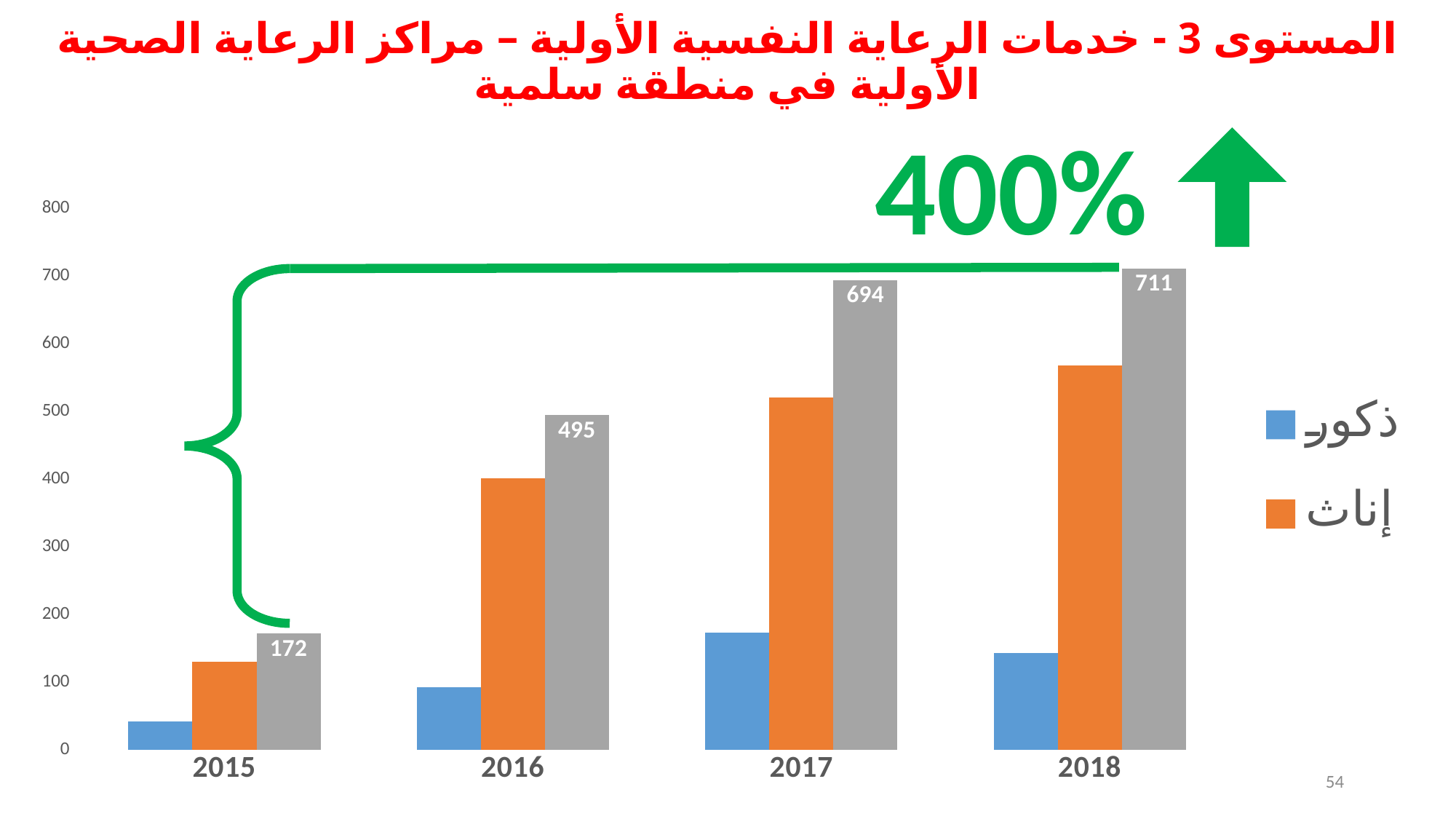
What kind of chart is shown on the slide? bar chart Is the value of the orange (إناث) bar for 2018 greater or less than 500? greater Is the value of the blue (ذكور) bar for 2015 greater or less than 100? less What is the value of the gray bar for 2018? 711 How many years are shown on the x axis? 4 Do the gray bar values rise or fall from 2015 to 2018? rise What is the difference between the gray bar values for 2018 and 2015? 539 Which year has the lowest gray bar? 2015 What is the difference between the gray bar values for 2017 and 2016? 199 Which year has the highest gray bar? 2018 What is the value of the gray bar for 2015? 172 What is the value of the gray bar for 2016? 495